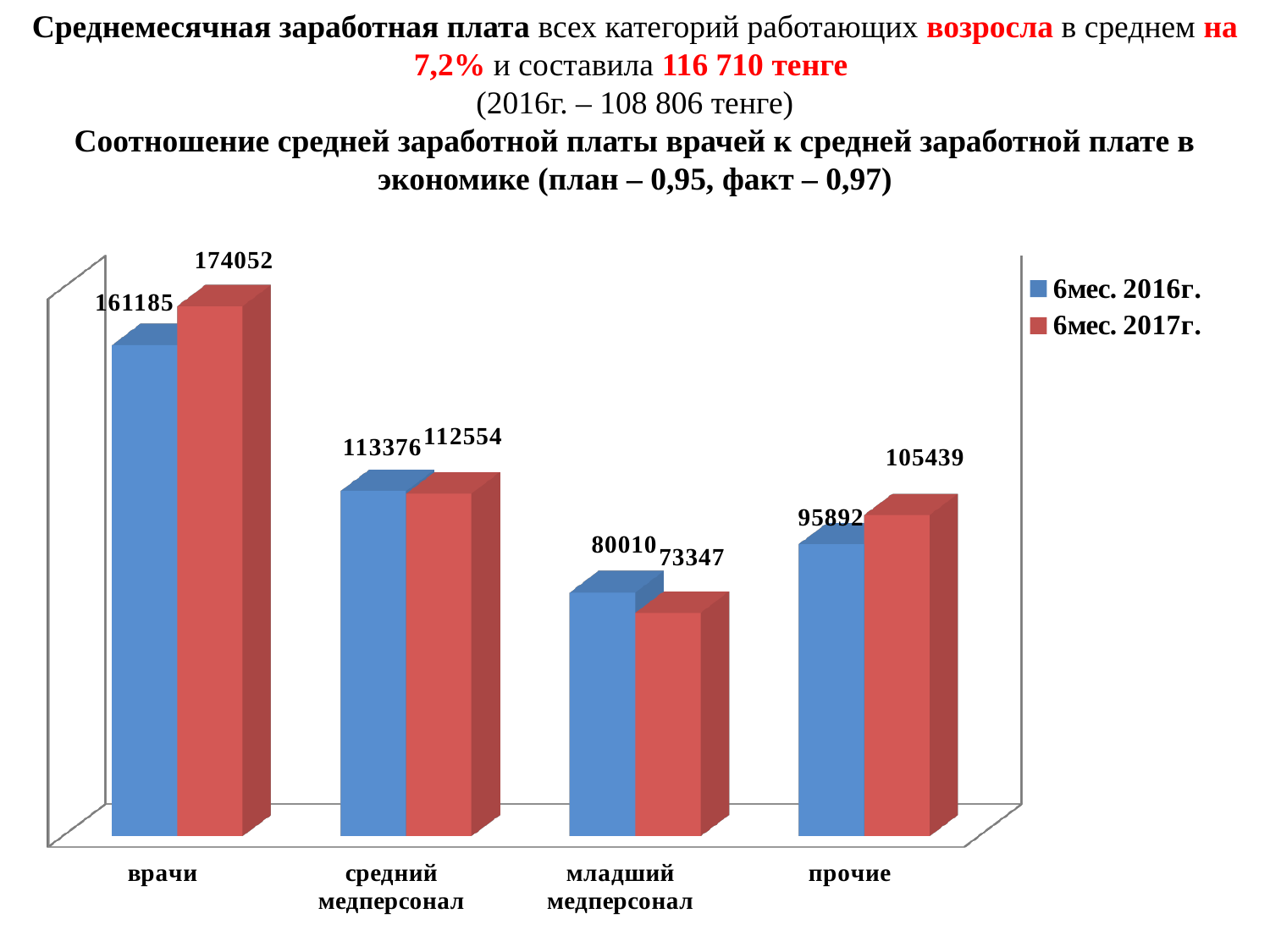
For младший медперсонал, which series has the larger value: 6мес. 2016г. or 6мес. 2017г.? 6мес. 2016г. How many categories are shown on the x axis of the chart? 4 Which category has the lowest value in the 6мес. 2016г. series? младший медперсонал What is the value for прочие in the 6мес. 2017г. series? 105439 What is the value for младший медперсонал in the 6мес. 2016г. series? 80010 What is the value for врачи in the 6мес. 2017г. series? 174052 What is the difference between the 6мес. 2017г. and 6мес. 2016г. values for врачи? 12867 What type of chart is shown on the slide? bar chart Which category has the highest value in the 6мес. 2017г. series? врачи How many series does the legend list? 2 Which colour represents the 6мес. 2017г. series in the chart? red What is the value for средний медперсонал in the 6мес. 2016г. series? 113376